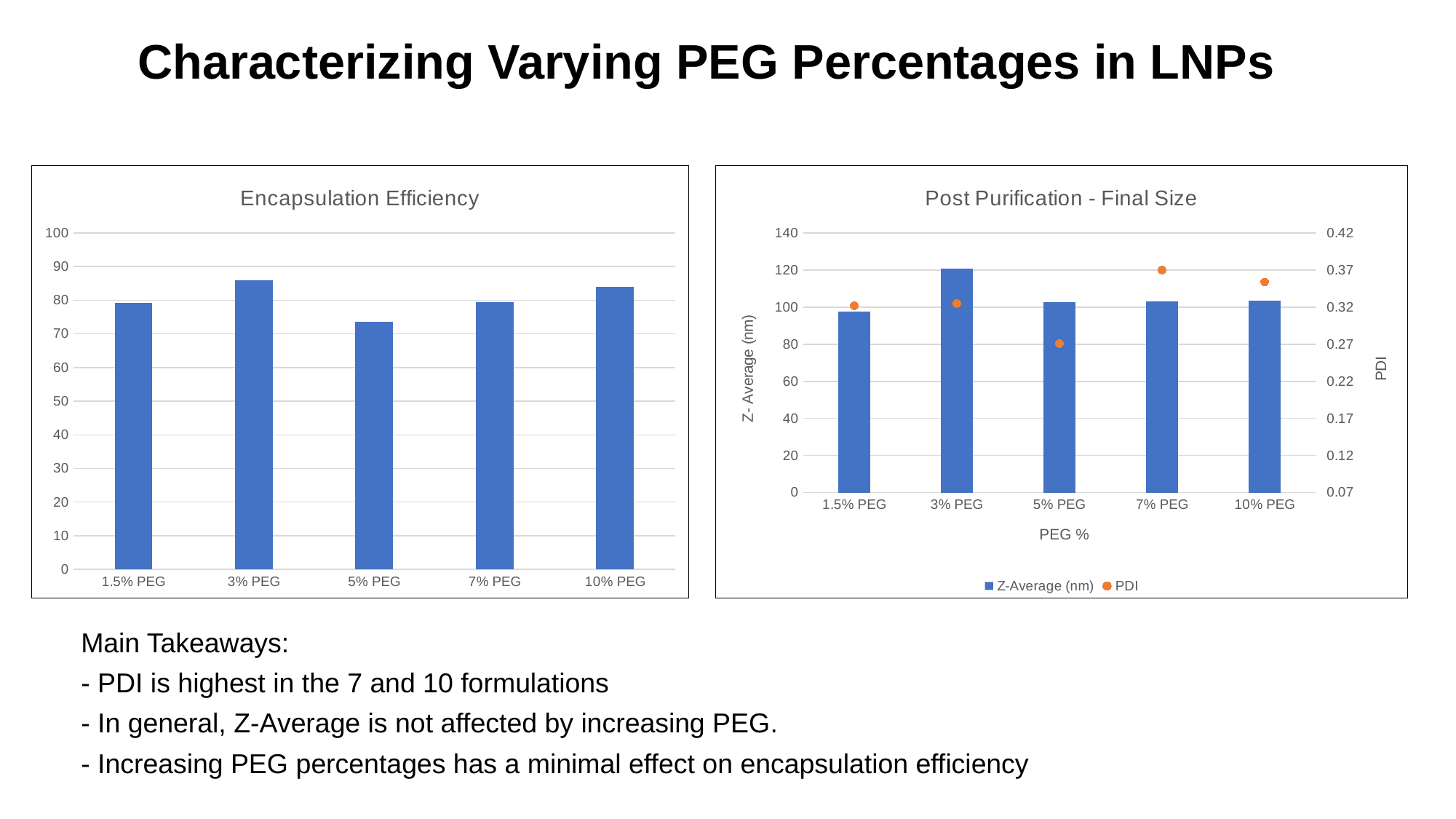
In the Post Purification - Final Size chart, which PEG percentage has the highest PDI? 7% PEG In the Encapsulation Efficiency chart, is the value for 5% PEG greater or less than 80? less In the Encapsulation Efficiency chart, which PEG percentage has the lowest encapsulation efficiency? 5% PEG In the Encapsulation Efficiency chart, which is larger, the value for 3% PEG or the value for 5% PEG? 3% PEG In the Post Purification - Final Size chart, which PEG percentage has the lowest PDI? 5% PEG How many PEG percentage categories are shown in the Encapsulation Efficiency chart? 5 How many series does the legend of the Post Purification - Final Size chart list? 2 In the Encapsulation Efficiency chart, which PEG percentage has the highest encapsulation efficiency? 3% PEG In the Post Purification - Final Size chart, is the PDI for 5% PEG greater or less than 0.32? less In the Post Purification - Final Size chart, which PEG percentage has the highest Z-Average (nm)? 3% PEG What kind of chart is the Encapsulation Efficiency chart? bar chart In the Encapsulation Efficiency chart, is the value for 10% PEG greater or less than 80? greater